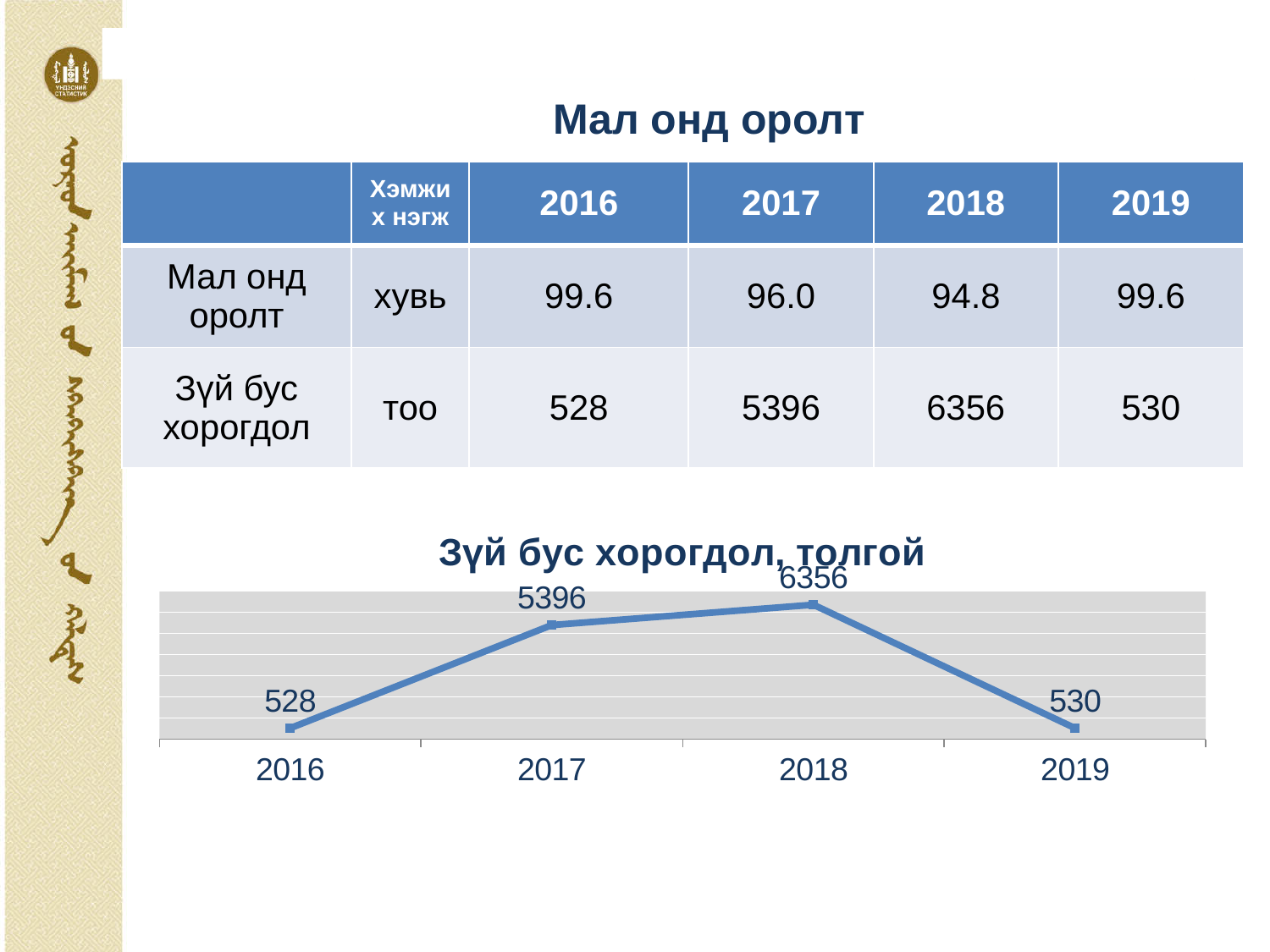
What is the value for 2016 in the chart? 528 What kind of chart is shown on the slide? line chart What is the value for 2017 in the chart? 5396 What is the title of the chart? Зүй бус хорогдол, толгой What is the value for 2019 in the chart? 530 Which is larger in the chart, the value for 2017 or the value for 2019? 2017 What is the difference between the values for 2018 and 2019 in the chart? 5826 Which year has the highest value in the chart? 2018 Does the value rise or fall from 2018 to 2019 in the chart? fall Which year has the lowest value in the chart? 2016 How many years are plotted in the chart? 4 What is the difference between the values for 2018 and 2017 in the chart? 960